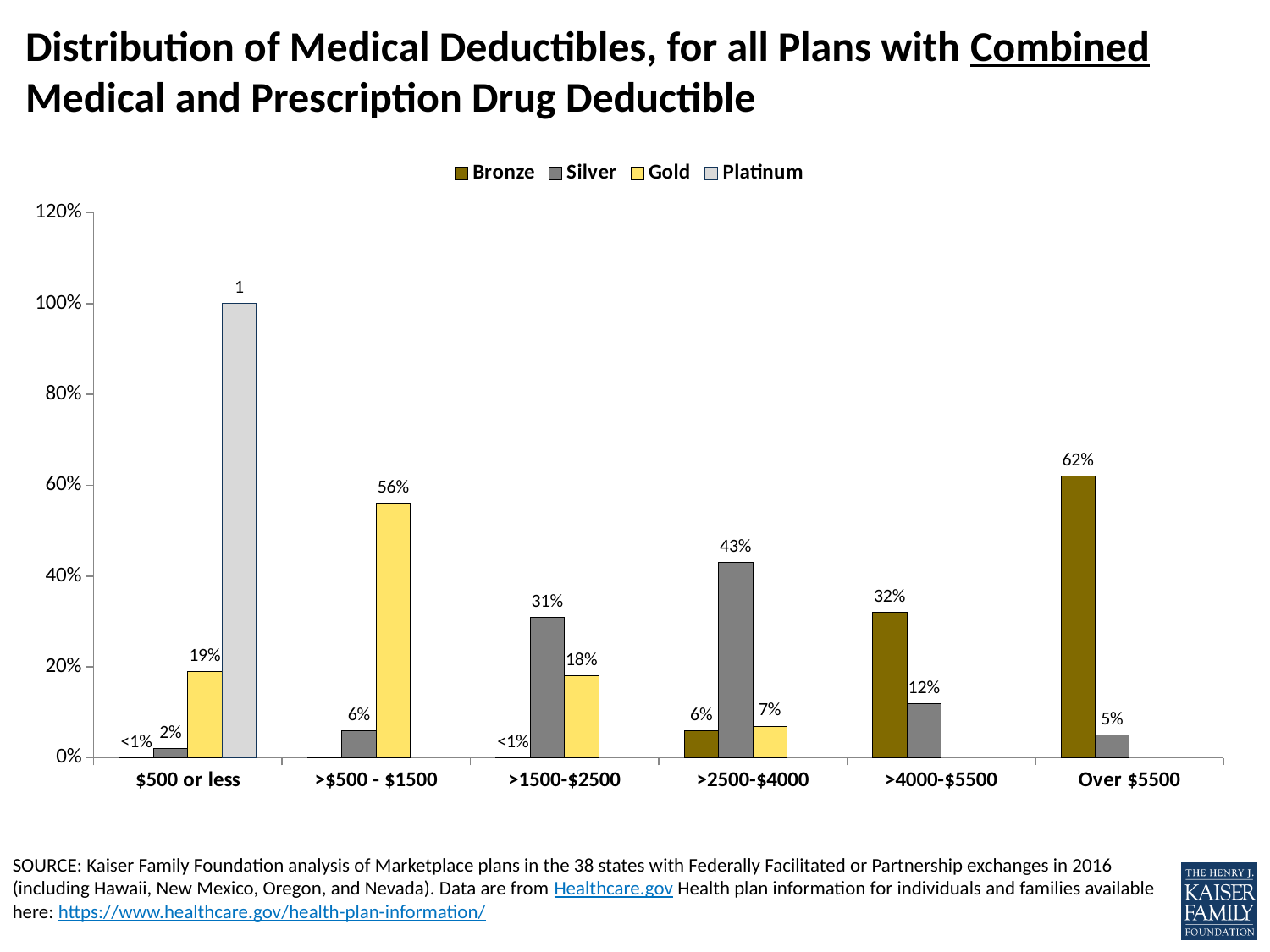
In which category is the Bronze value highest? Over $5500 Is the Platinum value for the $500 or less category greater or less than 80%? greater What is the Silver value for the >2500-$4000 category? 43% Do the Bronze values rise or fall as the deductible categories increase along the x axis? Rise What is the difference between the Silver and Gold values in the >1500-$2500 category? 13 percentage points How many series does the legend list? 4 What is the Gold value for the >$500 - $1500 category? 56% In the >$500 - $1500 category, which is larger, the Gold value or the Silver value? Gold What is the Bronze value for the Over $5500 category? 62% What kind of chart is shown on the slide? Bar chart How many deductible categories are shown on the x axis? 6 In which category is the Silver value highest? >2500-$4000